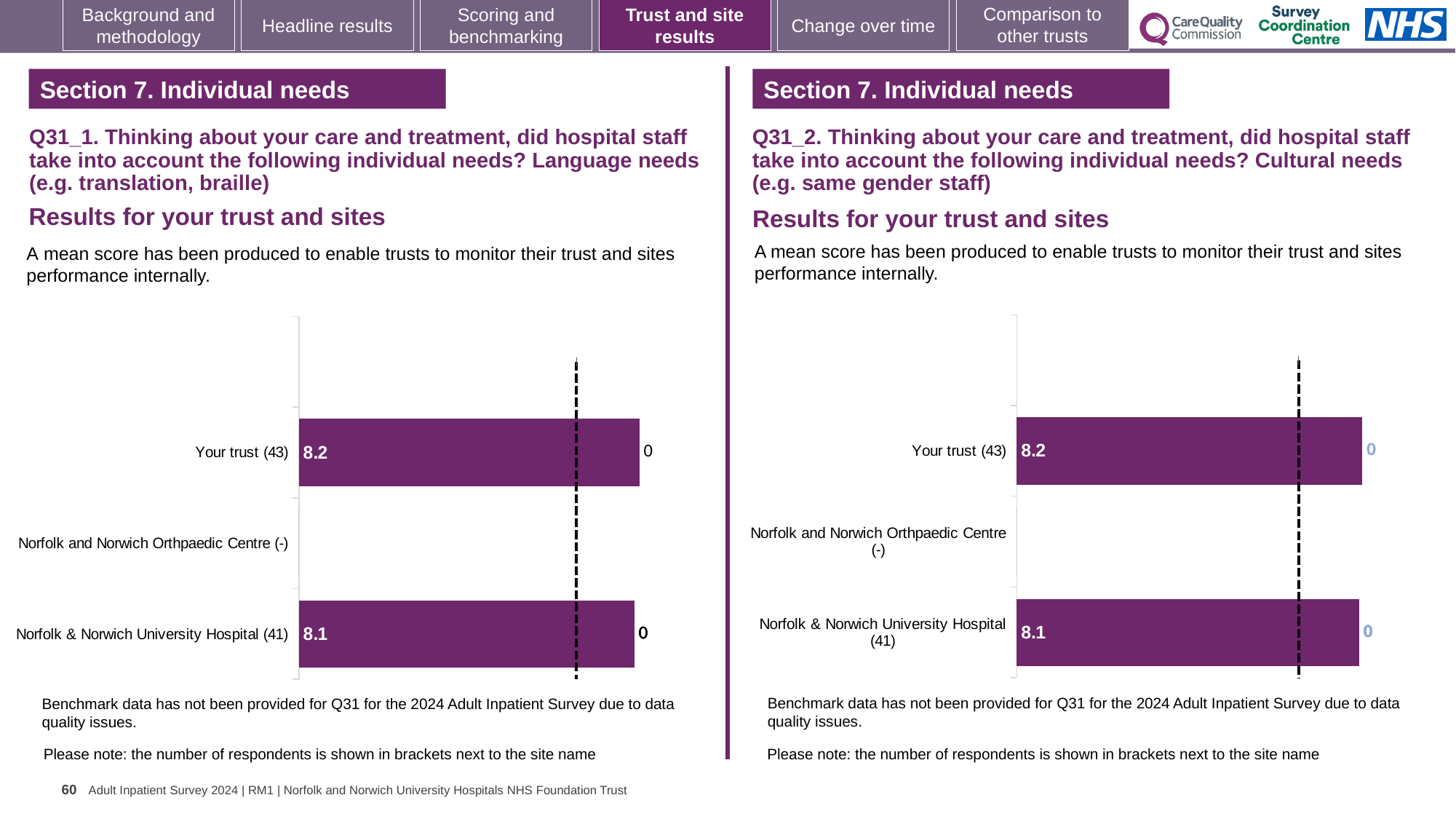
In the left chart (Q31_1, Language needs), which category has no bar plotted? Norfolk and Norwich Orthpaedic Centre (-) In the right chart (Q31_2, Cultural needs), what is the mean score for Your trust (43)? 8.2 In the left chart (Q31_1, Language needs), which category has the highest mean score? Your trust (43) What kind of chart is used in the right chart (Q31_2, Cultural needs)? Bar chart How many categories are listed on the y axis of the left chart (Q31_1, Language needs)? 3 In the left chart (Q31_1, Language needs), what is the mean score for Norfolk & Norwich University Hospital (41)? 8.1 In the left chart (Q31_1, Language needs), what is the difference between the mean score for Your trust (43) and Norfolk & Norwich University Hospital (41)? 0.1 In the right chart (Q31_2, Cultural needs), which category with a plotted bar has the lowest mean score? Norfolk & Norwich University Hospital (41) How many respondents are shown in brackets for Norfolk & Norwich University Hospital in the right chart (Q31_2, Cultural needs)? 41 In the right chart (Q31_2, Cultural needs), what is the mean score for Norfolk & Norwich University Hospital (41)? 8.1 In the right chart (Q31_2, Cultural needs), which is larger: the score for Your trust (43) or for Norfolk & Norwich University Hospital (41)? Your trust (43) In the left chart (Q31_1, Language needs), what is the mean score for Your trust (43)? 8.2